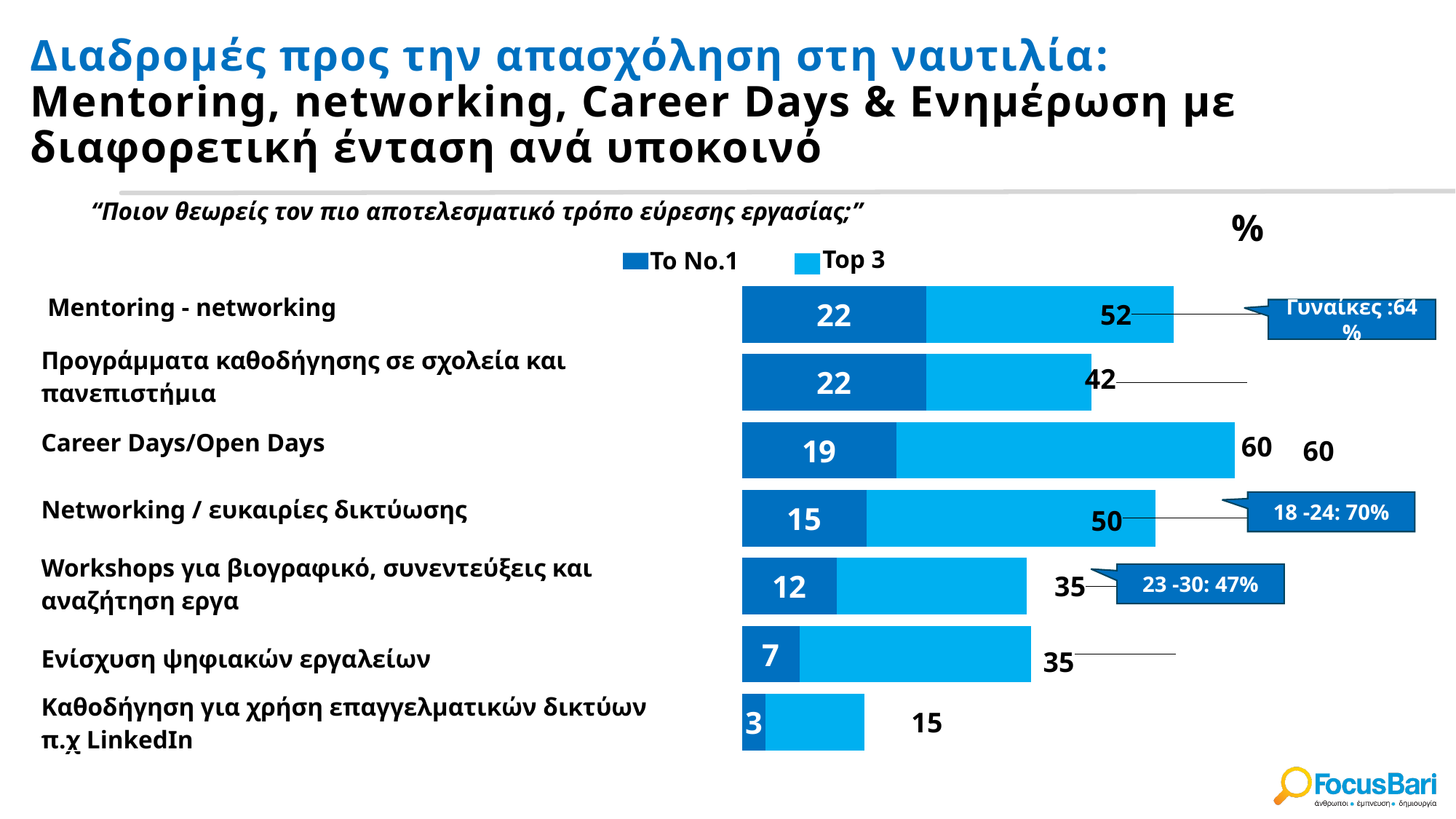
What kind of chart is shown on the slide? bar chart What is the difference between the Top 3 values for Mentoring - networking and Προγράμματα καθοδήγησης σε σχολεία και πανεπιστήμια? 10 Which category has the lowest Το No.1 value? Καθοδήγηση για χρήση επαγγελματικών δικτύων π.χ LinkedIn Which has a larger Το No.1 value: Career Days/Open Days or Workshops για βιογραφικό, συνεντεύξεις και αναζήτηση εργα? Career Days/Open Days What are the two legend entries of the chart? Το No.1 and Top 3 How many categories are plotted in the chart? 7 What is the Top 3 value for Career Days/Open Days? 60 What is the difference between the Το No.1 values for Ενίσχυση ψηφιακών εργαλείων and Καθοδήγηση για χρήση επαγγελματικών δικτύων π.χ LinkedIn? 4 What is the Top 3 value for Καθοδήγηση για χρήση επαγγελματικών δικτύων π.χ LinkedIn? 15 How many series does the legend list? 2 What is the Το No.1 value for Networking / ευκαιρίες δικτύωσης? 15 Which category has the highest Top 3 value? Career Days/Open Days